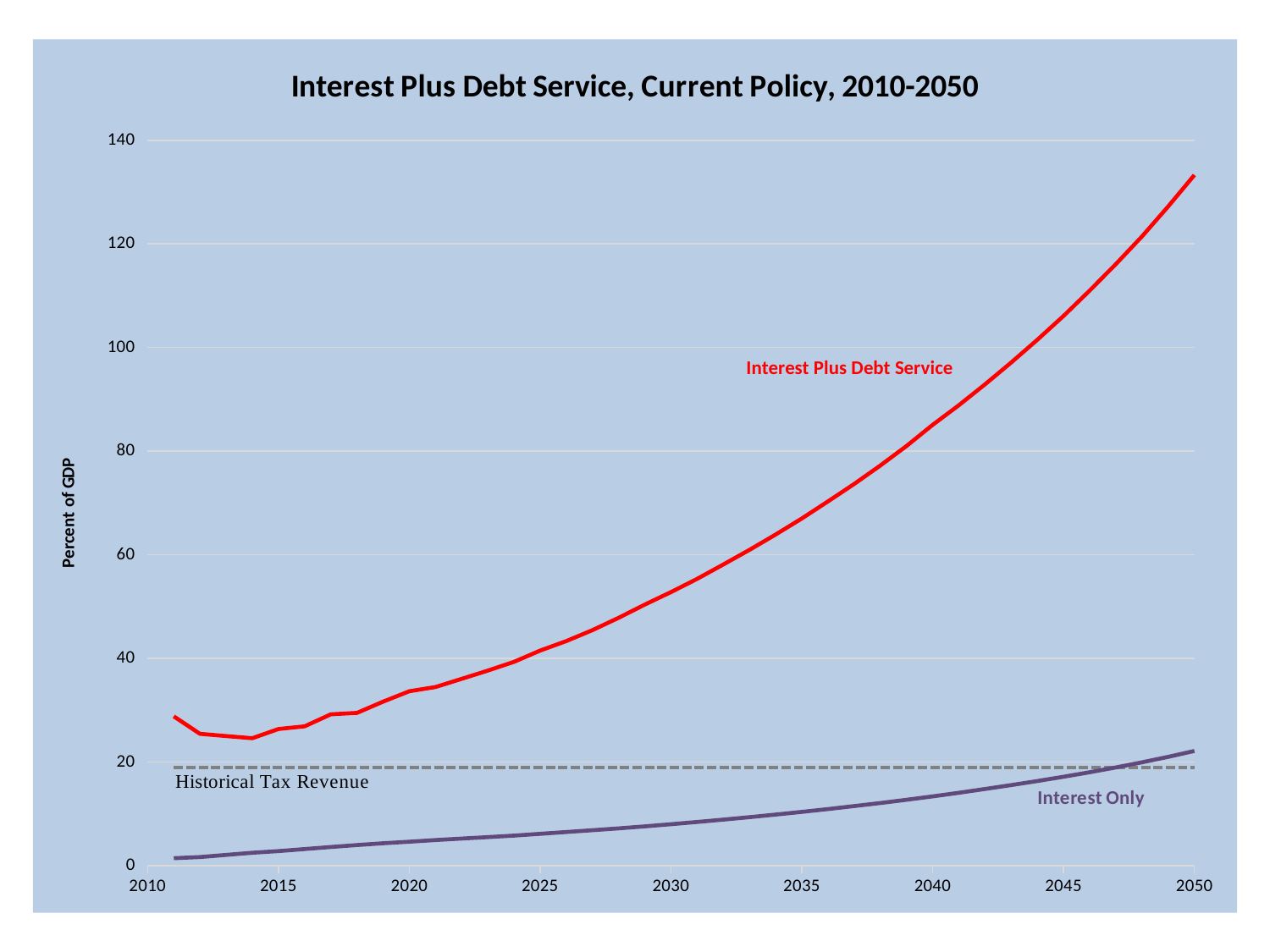
What is the title of the chart? Interest Plus Debt Service, Current Policy, 2010-2050 What kind of chart is shown on the slide? Line chart Is the value for Interest Plus Debt Service in 2020 greater or less than 40? less What is the label on the vertical axis of the chart? Percent of GDP Is the value for Interest Plus Debt Service in 2050 greater or less than 120? greater In 2050, which series has the larger value, Interest Plus Debt Service or Interest Only? Interest Plus Debt Service How many series are plotted on the chart? 3 Is the value for Interest Plus Debt Service in 2030 greater or less than 60? less Does the Interest Only line rise or fall from 2010 to 2050? Rise Which series reaches the highest value on the chart? Interest Plus Debt Service